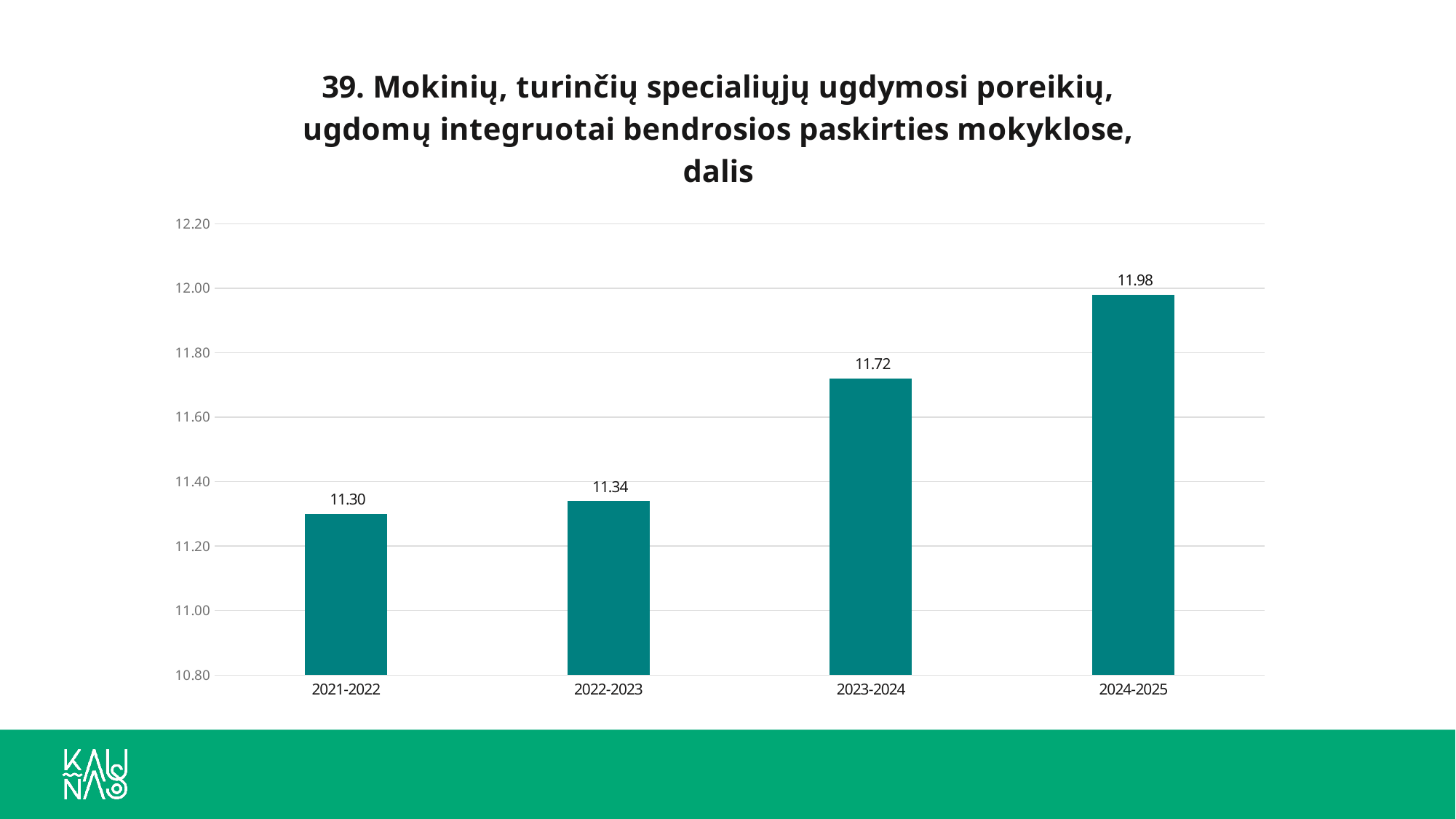
What is the difference between the values for 2023-2024 and 2022-2023? 0.38 How many school years are shown on the chart? 4 What is the value for 2021-2022? 11.30 What is the difference between the values for 2024-2025 and 2021-2022? 0.68 What is the value for 2023-2024? 11.72 Which is larger, the value for 2023-2024 or the value for 2022-2023? 2023-2024 What is the value for 2022-2023? 11.34 What is the value for 2024-2025? 11.98 Is the value for 2024-2025 greater or less than 12.00? less What kind of chart is shown on the slide? bar chart Which school year has the lowest value? 2021-2022 Which school year has the highest value? 2024-2025